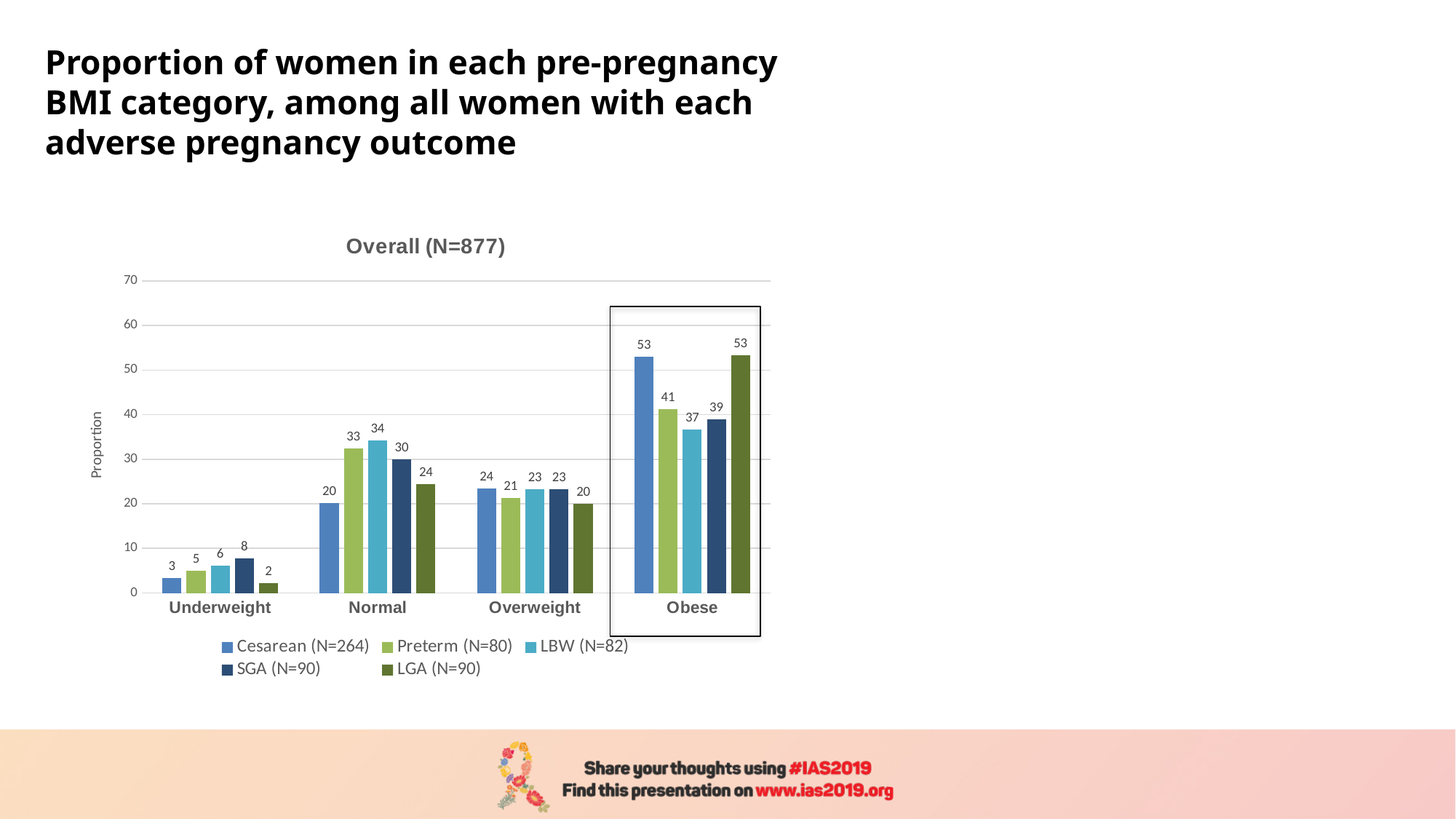
How many series does the legend list? 5 What is the value for LGA (N=90) in the Underweight category? 2 In the Normal category, which is larger: the value for Preterm (N=80) or the value for LGA (N=90)? Preterm (N=80) What is the title of the chart? Overall (N=877) What is the difference between the Cesarean (N=264) and LBW (N=82) values in the Obese category? 16 What is the value for LBW (N=82) in the Normal category? 34 What is the value for SGA (N=90) in the Overweight category? 23 Which BMI category has the lowest value for SGA (N=90)? Underweight What is the value for Cesarean (N=264) in the Obese category? 53 What kind of chart is shown on the slide? Bar chart How many BMI categories are shown on the x axis? 4 Which BMI category has the highest value for Preterm (N=80)? Obese